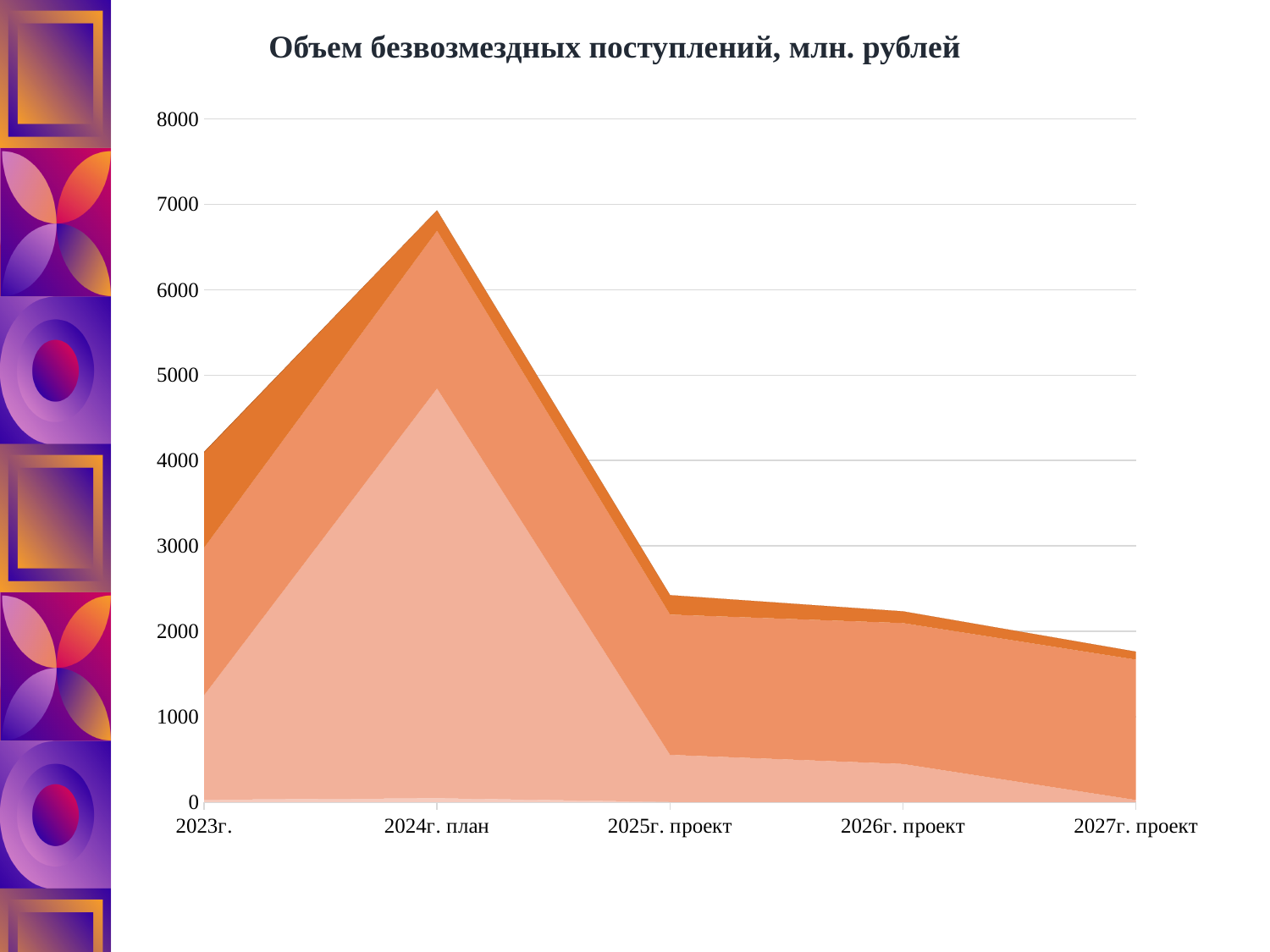
What is the title of the chart? Объем безвозмездных поступлений, млн. рублей Which category has the highest total value? 2024г. план Is the total value for 2024г. план greater or less than 6000? greater Is the total value for 2026г. проект greater or less than 1000? greater Do the total values rise or fall from 2024г. план to 2027г. проект? fall Which category has the lowest total value? 2027г. проект Is the total value for 2023г. greater or less than 3000? greater What kind of chart is shown on the slide? area chart How many categories are shown on the x axis? 5 Which has the larger total value, 2023г. or 2025г. проект? 2023г.